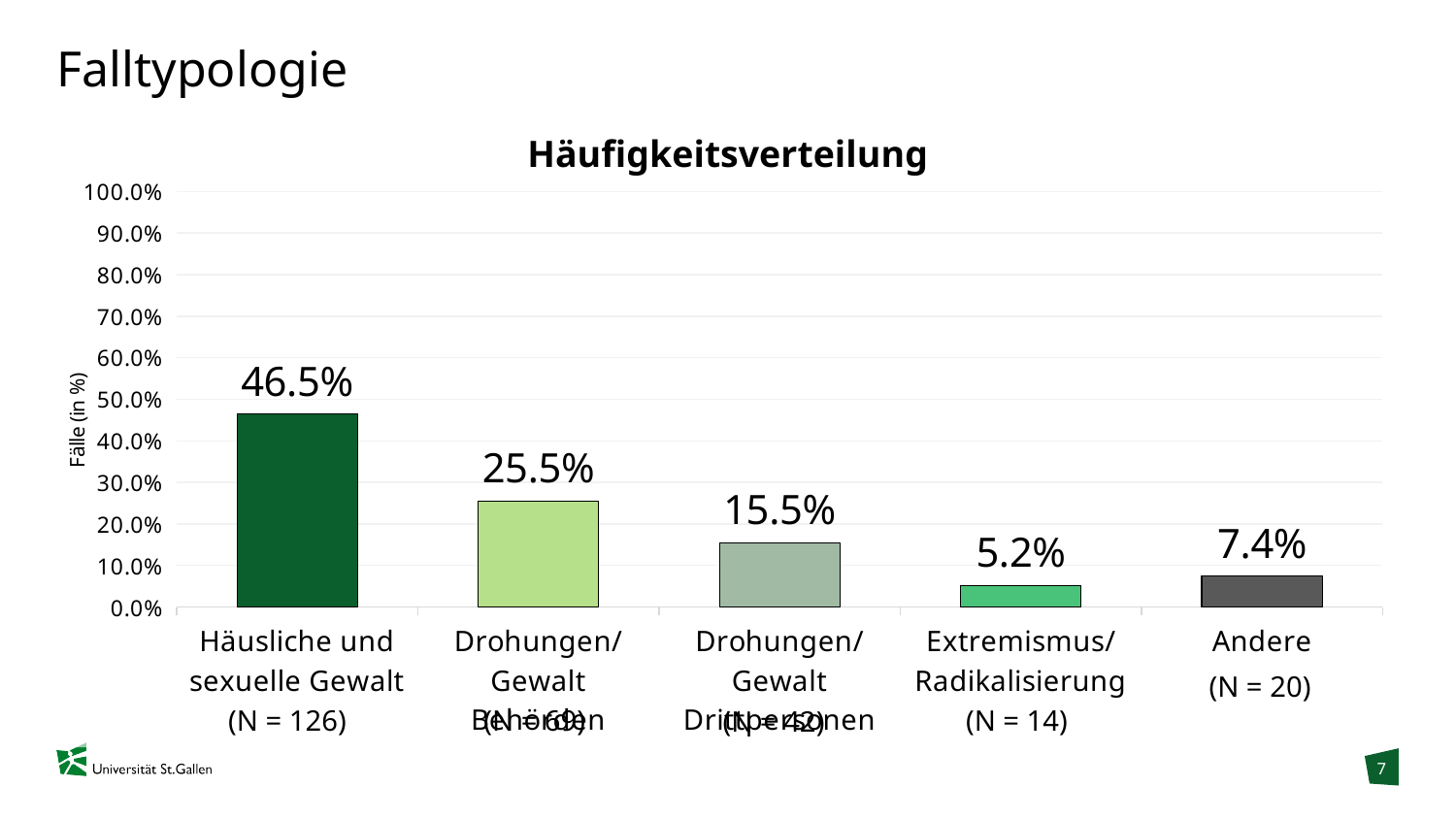
How many categories are shown in the chart? 5 What is the label on the vertical axis? Fälle (in %) What type of chart is shown on the slide? bar chart Which is larger, the value for Andere or the value for Extremismus/Radikalisierung? Andere What is the title of the chart? Häufigkeitsverteilung What is the difference between the values for Häusliche und sexuelle Gewalt and Andere? 39.1% What is the value for Extremismus/Radikalisierung? 5.2% Which category has the lowest value? Extremismus/Radikalisierung What is the value for Häusliche und sexuelle Gewalt? 46.5% What is the value shown for the second bar (Drohungen/Gewalt Behörden)? 25.5% Which category has the highest value? Häusliche und sexuelle Gewalt What is the value for Andere? 7.4%